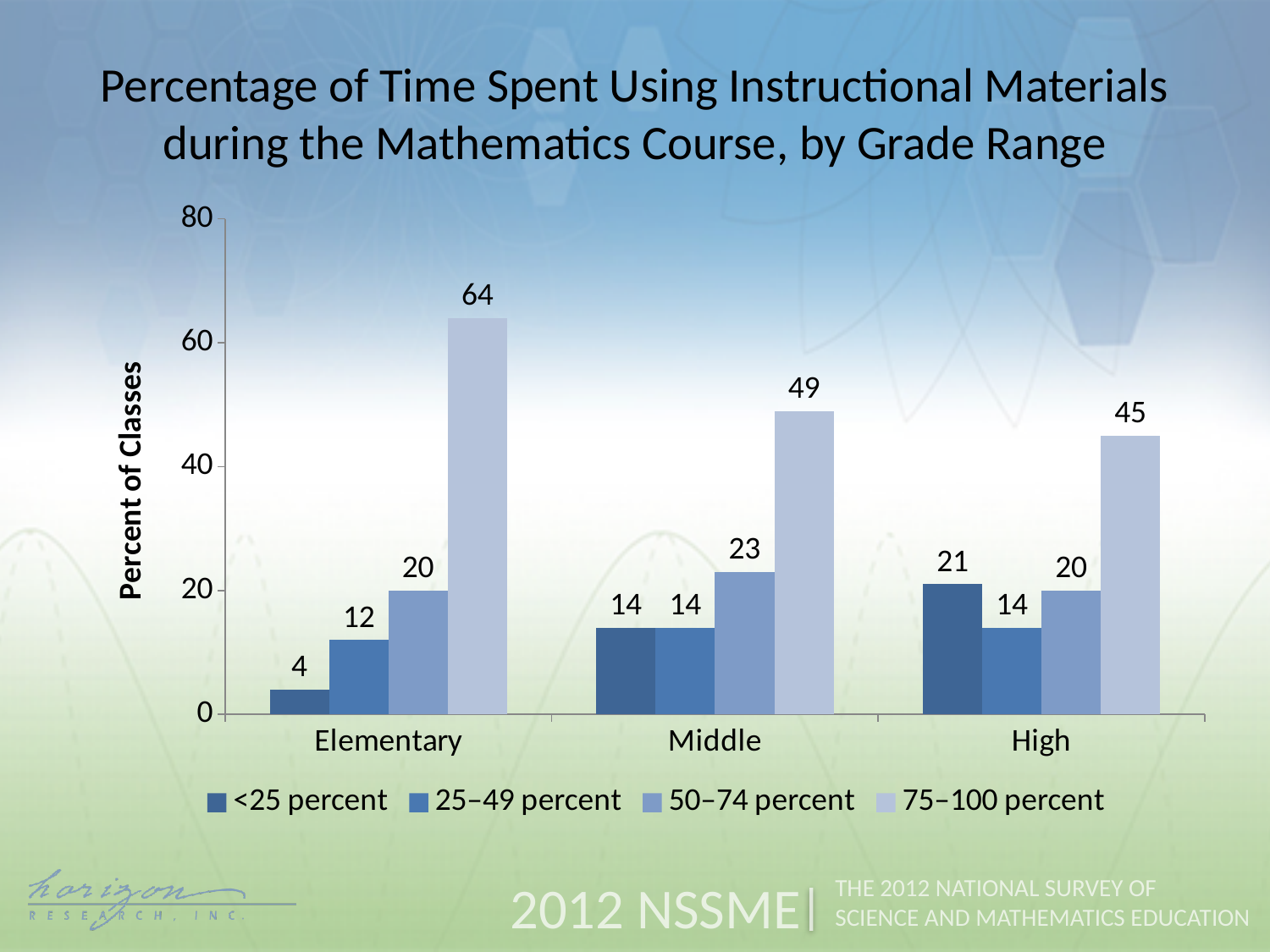
Which grade range has the highest value for the 75–100 percent series? Elementary What is the value for the <25 percent series in the High category? 21 Does the 75–100 percent value rise or fall from Elementary to High? Fall What is the difference between the 75–100 percent values for Elementary and High? 19 How many series does the legend list? 4 What is the label of the y axis? Percent of Classes Which is larger: the 25–49 percent value for Middle or the 25–49 percent value for Elementary? Middle What is the value for the 50–74 percent series in the Middle category? 23 How many grade range categories are shown on the x axis? 3 Which grade range has the lowest value for the <25 percent series? Elementary What is the value for the 75–100 percent series in the Elementary category? 64 What kind of chart is shown on the slide? Bar chart